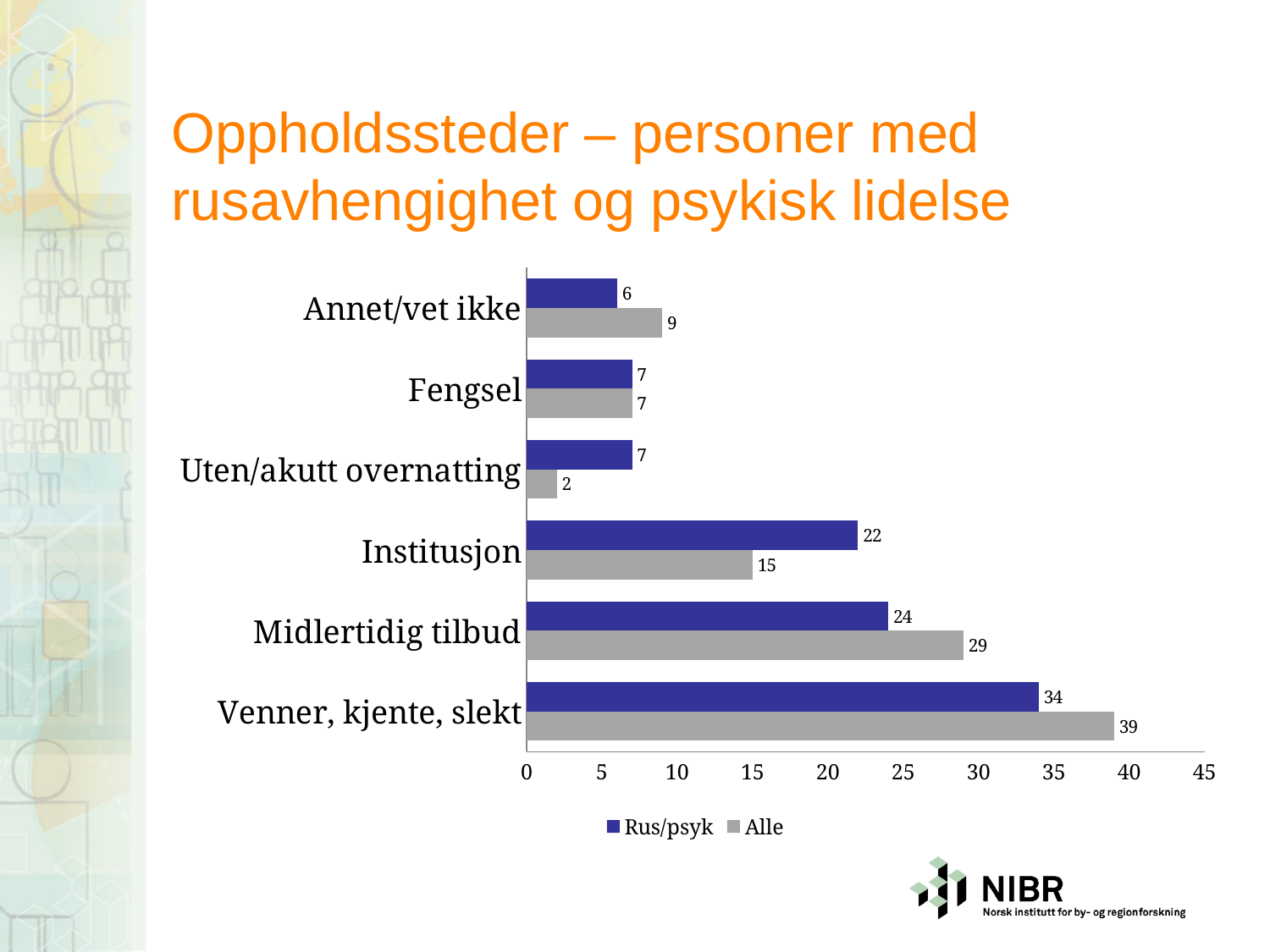
What is the Alle value for Midlertidig tilbud? 29 What kind of chart is shown on the slide? Bar chart Which category has the highest Rus/psyk value? Venner, kjente, slekt What is the Rus/psyk value for Institusjon? 22 What is the difference between the Alle and Rus/psyk values for Venner, kjente, slekt? 5 How many series does the legend list? 2 What is the Rus/psyk value for Fengsel? 7 Which is larger for Institusjon, the Rus/psyk value or the Alle value? Rus/psyk How many categories are shown on the chart? 6 Which category has the lowest Alle value? Uten/akutt overnatting Which series is shown in grey in the legend? Alle What is the Alle value for Uten/akutt overnatting? 2